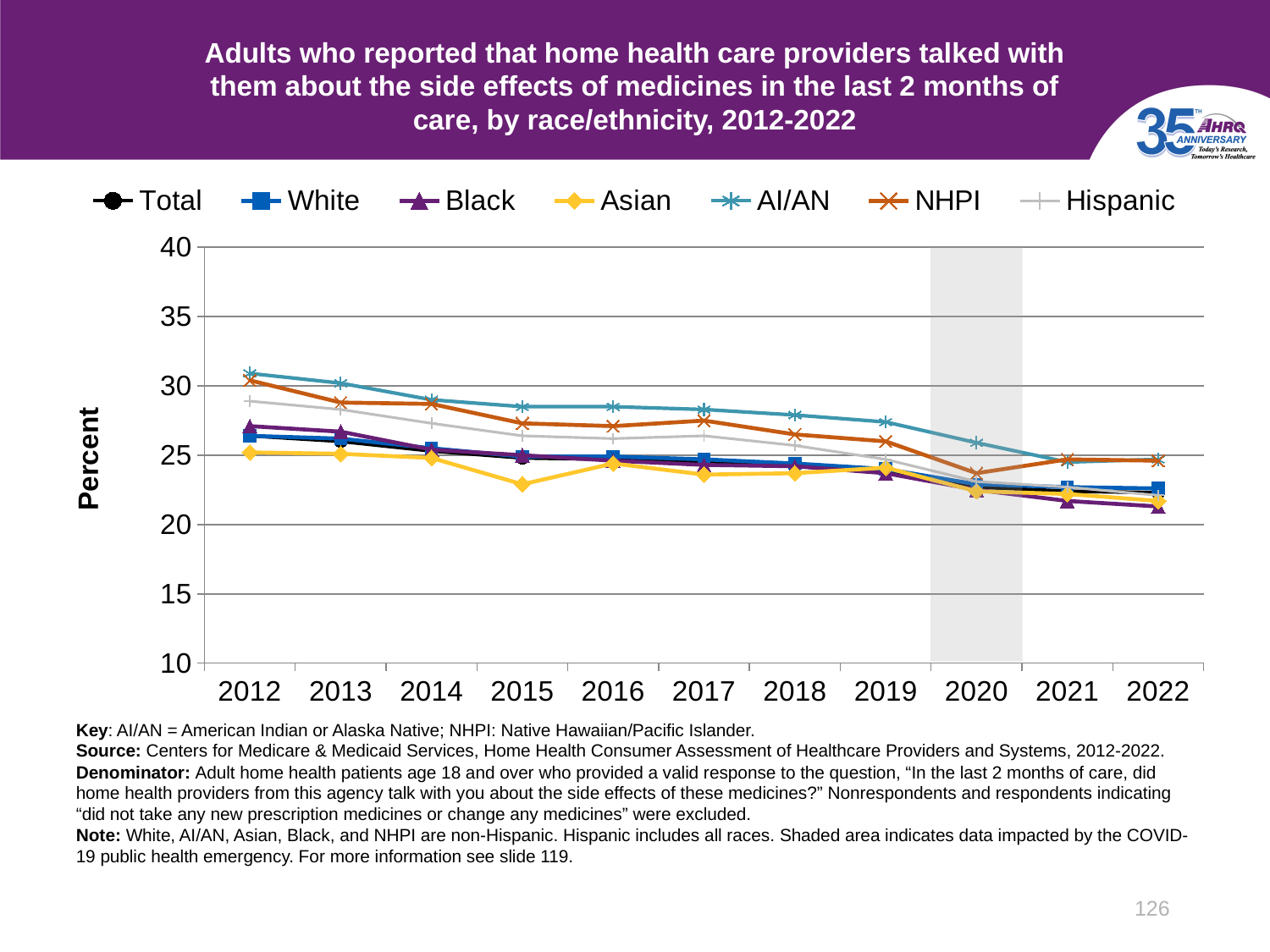
How many years are plotted along the x axis? 11 Is the value for Black in 2022 greater or less than 25? less Is the value for AI/AN in 2012 greater or less than 30? greater How many series does the legend list? 7 Does the AI/AN line rise or fall from 2012 to 2022? Fall What does the shaded area on the chart indicate? Data impacted by the COVID-19 public health emergency Which race/ethnicity group has the highest value in 2016? AI/AN Is the value for Hispanic in 2012 greater or less than 25? greater Which race/ethnicity group has the lowest value in 2015? Asian In 2015, which is larger, the value for Hispanic or the value for Asian? Hispanic What kind of chart is shown on the slide? Line chart